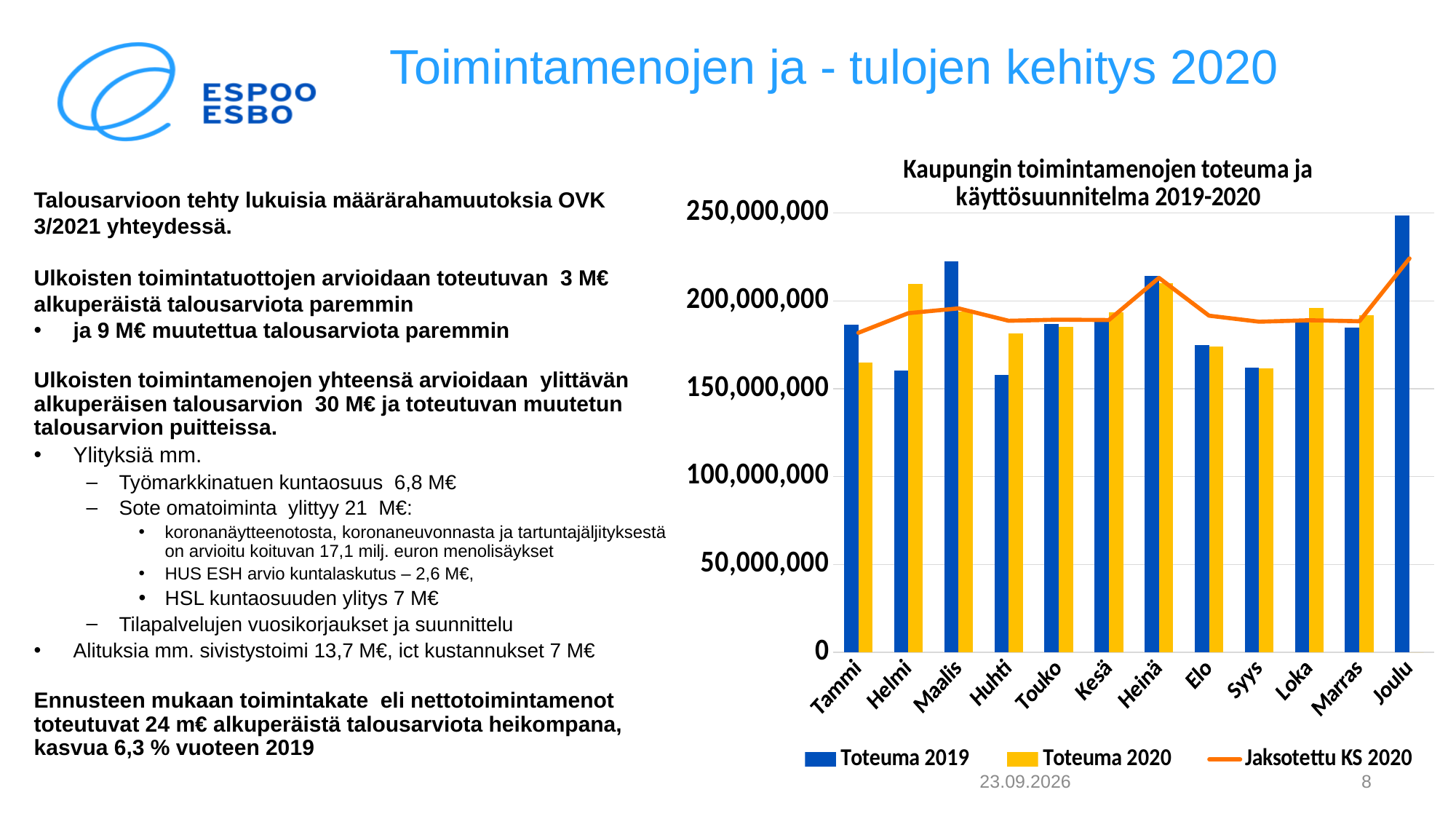
Is the Toteuma 2019 value for Huhti greater or less than 150,000,000? greater For Helmi, which is larger: Toteuma 2019 or Toteuma 2020? Toteuma 2020 Is the Toteuma 2020 value for Tammi greater or less than 200,000,000? less Does the Jaksotettu KS 2020 line rise or fall from Marras to Joulu? rise What is the title of the chart? Kaupungin toimintamenojen toteuma ja käyttösuunnitelma 2019-2020 Is the Toteuma 2020 value for Helmi greater or less than 200,000,000? greater For Tammi, which is larger: Toteuma 2019 or Toteuma 2020? Toteuma 2019 How many months are shown on the x axis of the chart? 12 Which month has the highest Toteuma 2019 value? Joulu How many series does the chart legend list? 3 What kind of chart is shown on the slide? Bar chart with a line